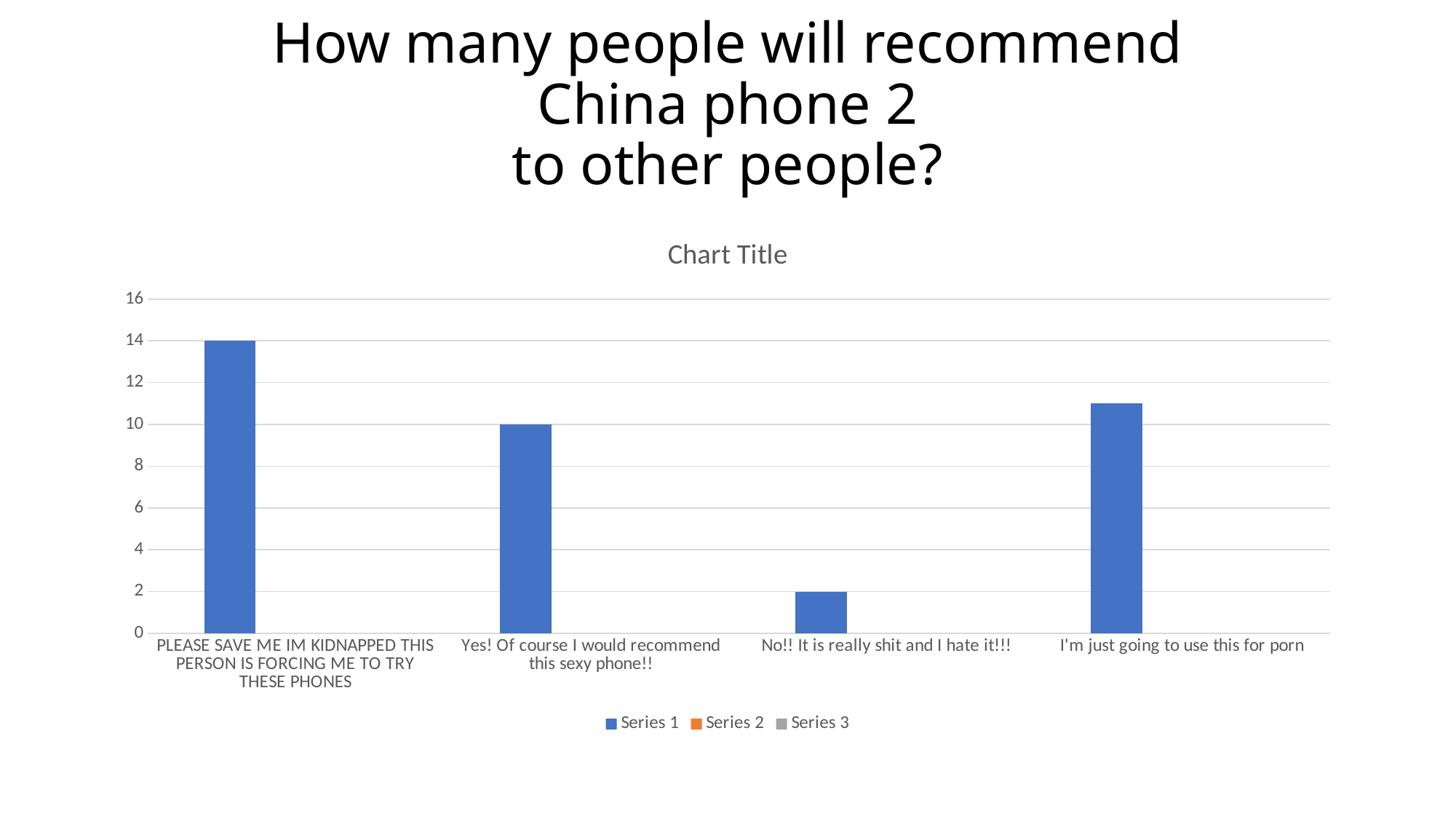
How many categories are shown on the x axis of the chart? 4 Which is larger: the value for "Yes! Of course I would recommend this sexy phone!!" or the value for "I'm just going to use this for porn"? I'm just going to use this for porn What is the value for "Yes! Of course I would recommend this sexy phone!!"? 10 What kind of chart is shown on the slide? bar chart What is the value for "No!! It is really shit and I hate it!!!"? 2 What is the title shown above the chart's plot area? Chart Title Which category has the highest value? PLEASE SAVE ME IM KIDNAPPED THIS PERSON IS FORCING ME TO TRY THESE PHONES What is the value for "PLEASE SAVE ME IM KIDNAPPED THIS PERSON IS FORCING ME TO TRY THESE PHONES"? 14 How many series does the chart's legend list? 3 What is the difference between the values for "PLEASE SAVE ME IM KIDNAPPED THIS PERSON IS FORCING ME TO TRY THESE PHONES" and "Yes! Of course I would recommend this sexy phone!!"? 4 Is the value for "I'm just going to use this for porn" greater or less than 10? greater Which category has the lowest value? No!! It is really shit and I hate it!!!